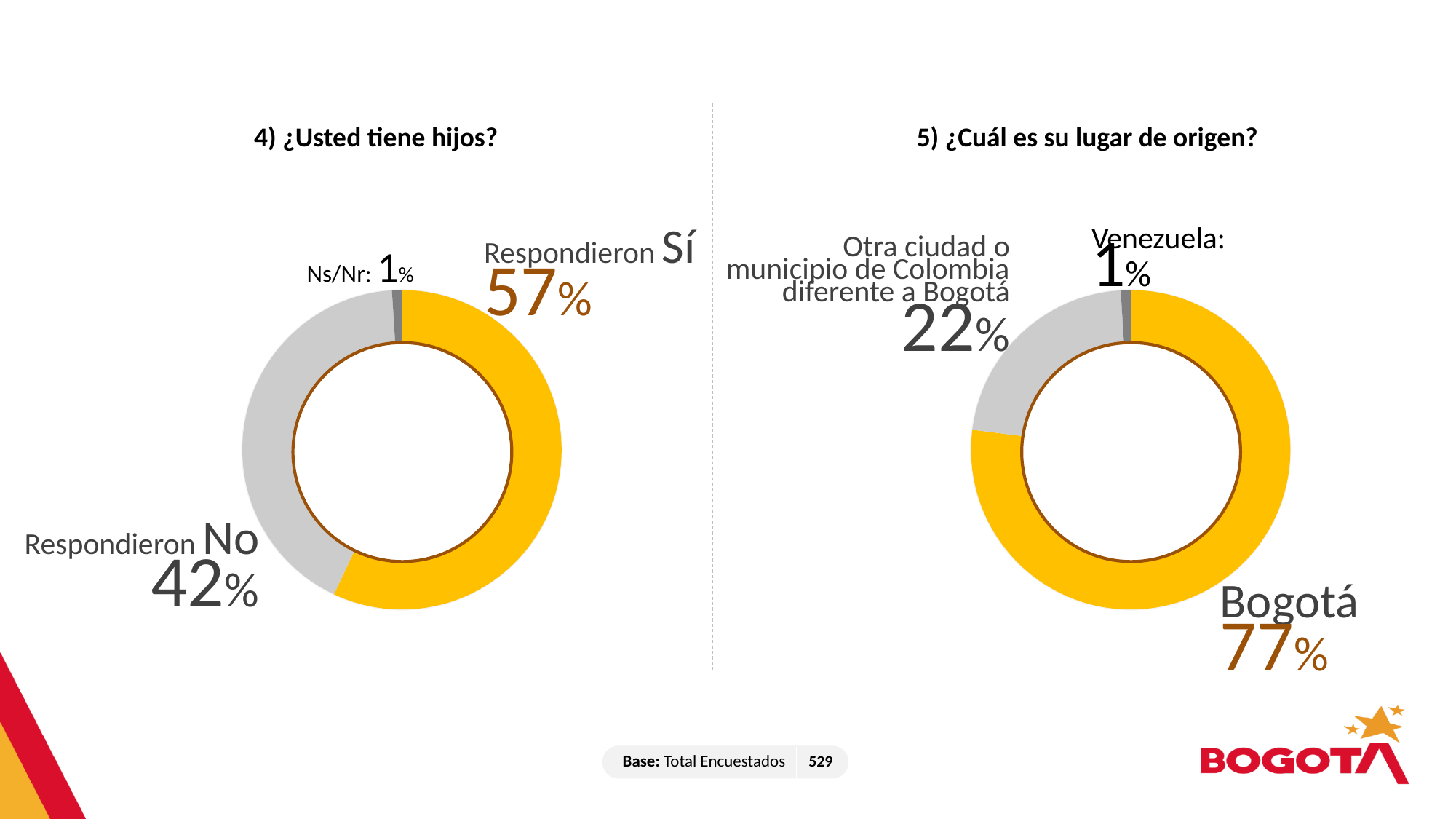
In the chart '5) ¿Cuál es su lugar de origen?', how much larger is the Bogotá share than the share for other Colombian cities? 55% In the chart '4) ¿Usted tiene hijos?', what percentage of respondents answered No? 42% In the chart '4) ¿Usted tiene hijos?', which response has the largest share? Respondieron Sí In the chart '4) ¿Usted tiene hijos?', what percentage of respondents answered Sí? 57% What type of chart is used for '4) ¿Usted tiene hijos?'? Doughnut (pie) chart In the chart '5) ¿Cuál es su lugar de origen?', which category has the smallest share? Venezuela In the chart '4) ¿Usted tiene hijos?', what is the value for Ns/Nr? 1% In the chart '4) ¿Usted tiene hijos?', what is the difference between the Sí and No shares? 15% How many categories does the chart '5) ¿Cuál es su lugar de origen?' show? 3 In the chart '5) ¿Cuál es su lugar de origen?', what percentage are from another city or municipality of Colombia different from Bogotá? 22% In the chart '5) ¿Cuál es su lugar de origen?', what is the value for Venezuela? 1% In the chart '5) ¿Cuál es su lugar de origen?', what percentage of respondents are from Bogotá? 77%